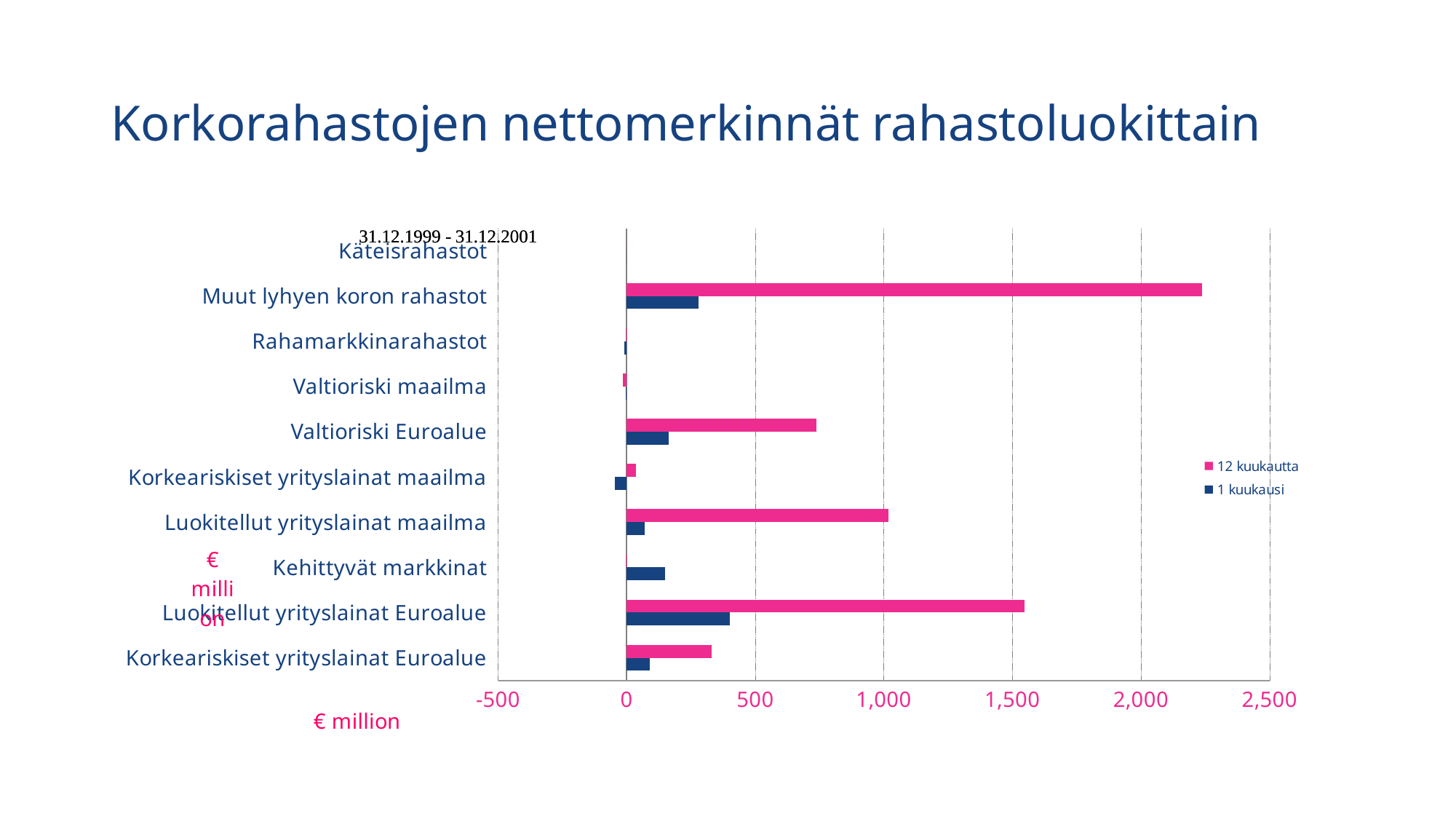
How many series does the legend list? 2 Is the 1 kuukausi value for Luokitellut yrityslainat Euroalue greater or less than 500? less For the 12 kuukautta series, which is larger: Luokitellut yrityslainat maailma or Valtioriski Euroalue? Luokitellut yrityslainat maailma Which category has the highest value for the 12 kuukautta series? Muut lyhyen koron rahastot What kind of chart is shown on the slide? bar chart How many fund categories are shown on the vertical axis? 10 Is the 12 kuukautta value for Muut lyhyen koron rahastot greater or less than 2,000? greater Which category has the highest value for the 1 kuukausi series? Luokitellut yrityslainat Euroalue What unit label is shown on the horizontal axis? € million Is the 12 kuukautta value for Korkeariskiset yrityslainat Euroalue greater or less than 500? less What is the title of the chart on the slide? Korkorahastojen nettomerkinnät rahastoluokittain